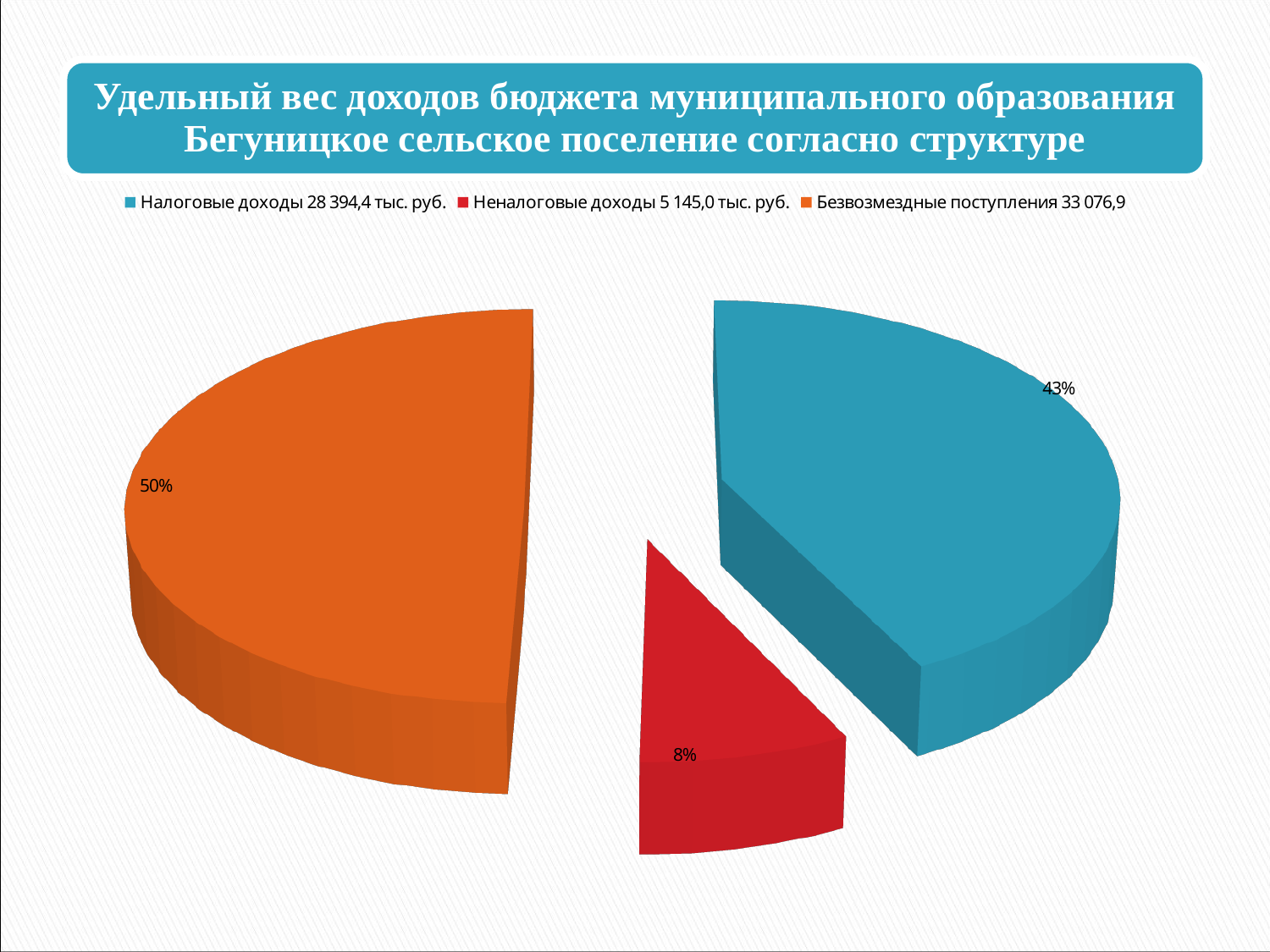
Which category has the largest slice of the pie? Безвозмездные поступления What share of the pie does the slice for Налоговые доходы have? 43% Which category has the smallest slice of the pie? Неналоговые доходы How many entries does the legend list? 3 How many slices does the pie chart have? 3 What share of the pie does the slice for Безвозмездные поступления have? 50% What share of the pie does the slice for Неналоговые доходы have? 8% What amount is given in the legend for Налоговые доходы? 28 394,4 тыс. руб. What is the difference in percentage points between the Безвозмездные поступления slice and the Налоговые доходы slice? 7 What kind of chart is shown on the slide? Pie chart What colour is the slice for Неналоговые доходы? Red Which slice is larger: Налоговые доходы or Неналоговые доходы? Налоговые доходы